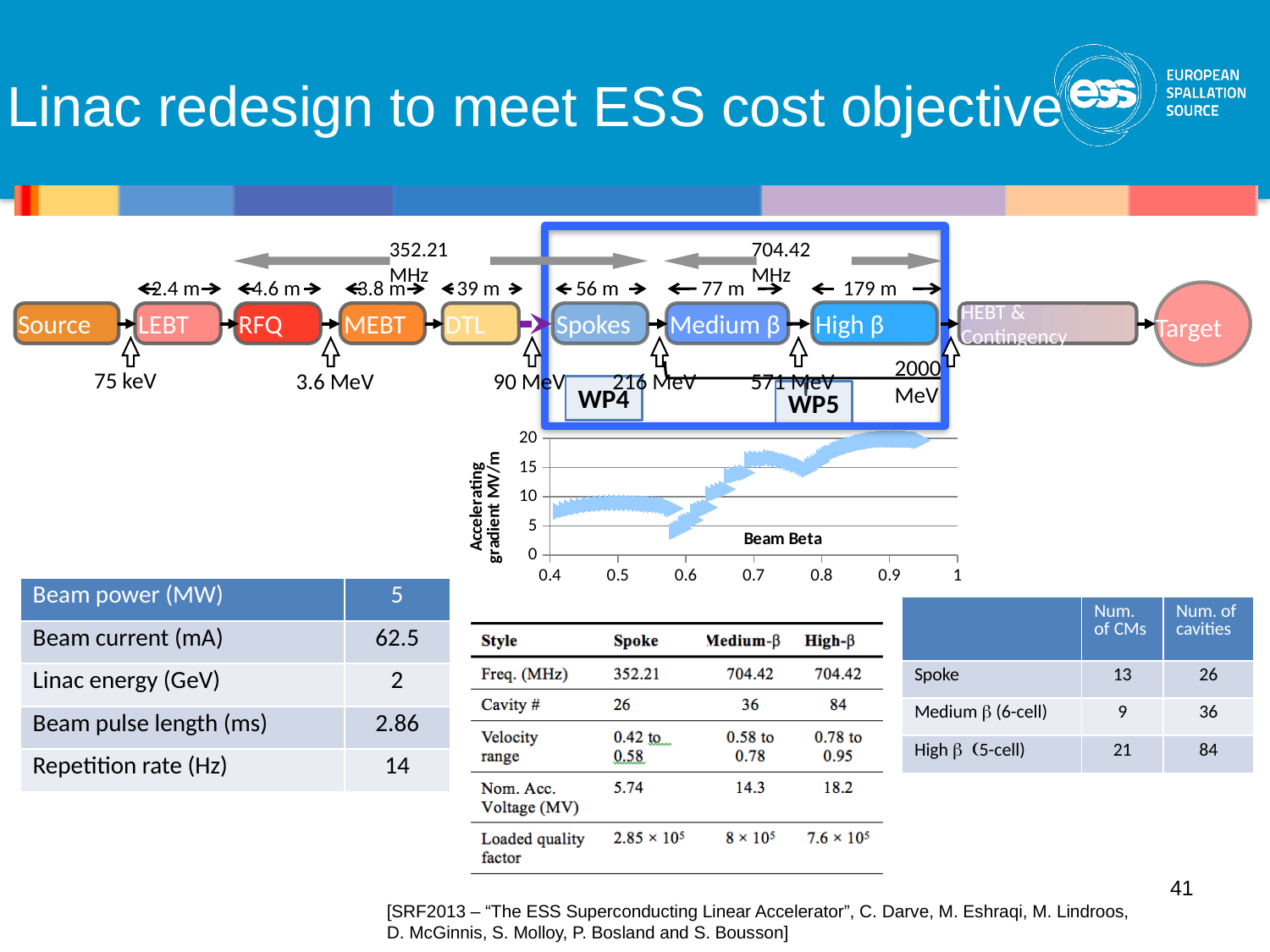
What is the label of the x axis of the chart? Beam Beta Is the lowest accelerating gradient shown on the chart greater or less than 5 MV/m? less Is the accelerating gradient at a beam beta of 0.7 greater or less than 10 MV/m? greater Overall, does the accelerating gradient rise or fall as beam beta increases from 0.4 to 1? rise Is the accelerating gradient at a beam beta of 0.4 greater or less than 10 MV/m? less What is the label of the y axis of the chart? Accelerating gradient MV/m Is the accelerating gradient higher at a beam beta of 0.9 or at a beam beta of 0.4? 0.9 What is the highest value shown on the y axis of the chart? 20